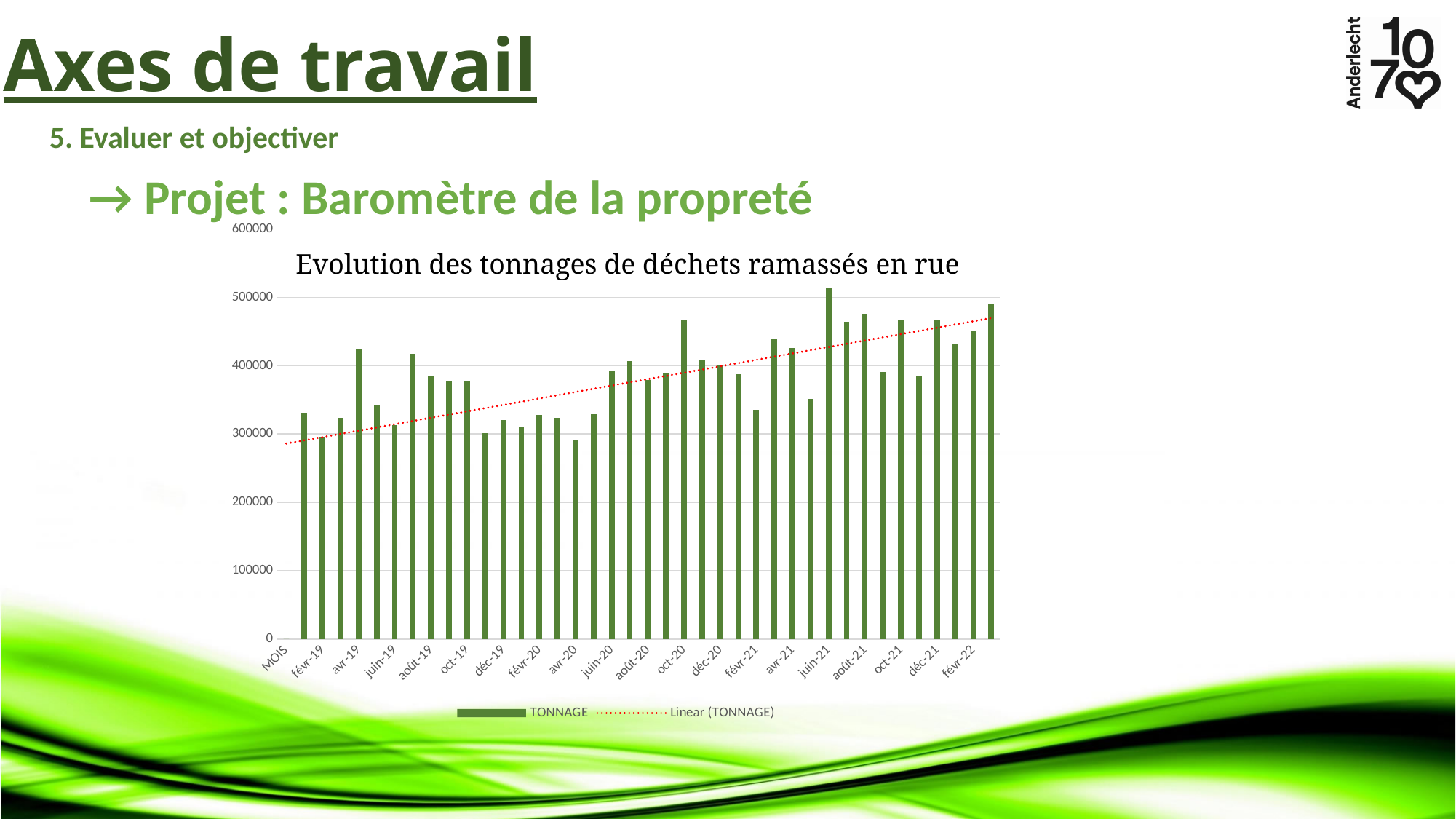
How many entries does the chart legend list? 2 What are the two entries in the chart legend? TONNAGE and Linear (TONNAGE) Does the linear trend line show tonnage rising or falling over time? Rising Which is larger, the tonnage for juin-21 or for avr-20? juin-21 Is the value for avr-20 greater or less than 300000? less Is the value for juin-21 greater or less than 400000? greater Is the value for févr-19 greater or less than 400000? less Which month has the highest tonnage bar? juin-21 What kind of chart is shown on the slide? Bar chart What is the title of the chart? Evolution des tonnages de déchets ramassés en rue